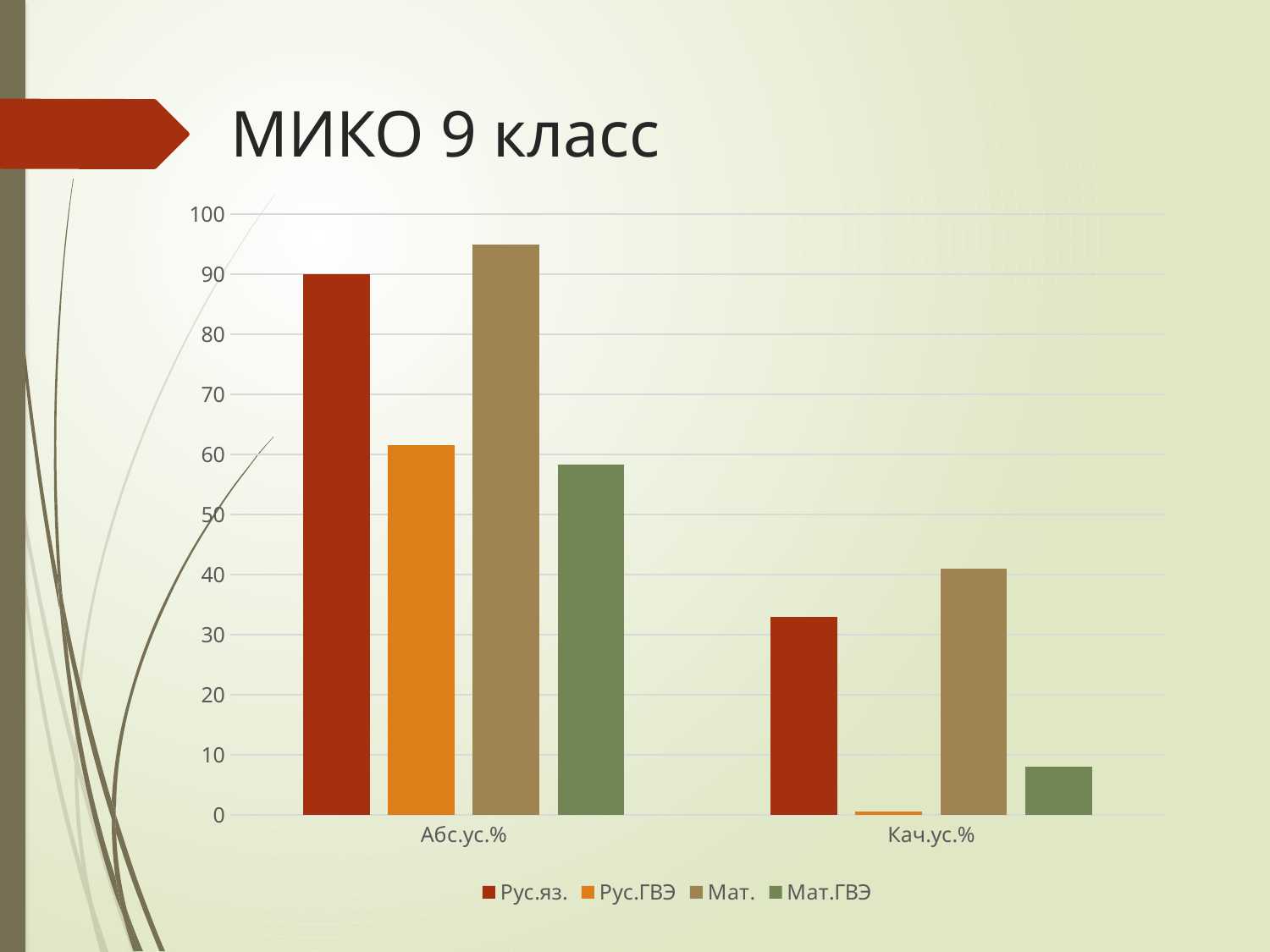
Is the value for Рус.ГВЭ in the Абс.ус.% category greater or less than 70? less Which series has the lowest value in the Кач.ус.% category? Рус.ГВЭ Which series has the lowest value in the Абс.ус.% category? Мат.ГВЭ Is the value for Мат.ГВЭ in the Кач.ус.% category greater or less than 10? less How many categories are shown on the x axis? 2 Which series has the highest value in the Кач.ус.% category? Мат. In the Кач.ус.% category, which is larger: Рус.яз. or Мат.? Мат. Which series has the highest value in the Абс.ус.% category? Мат. What is the value for Рус.яз. in the Абс.ус.% category? 90 What is the title of the chart? МИКО 9 класс What kind of chart is shown on the slide? bar chart How many series does the legend list? 4